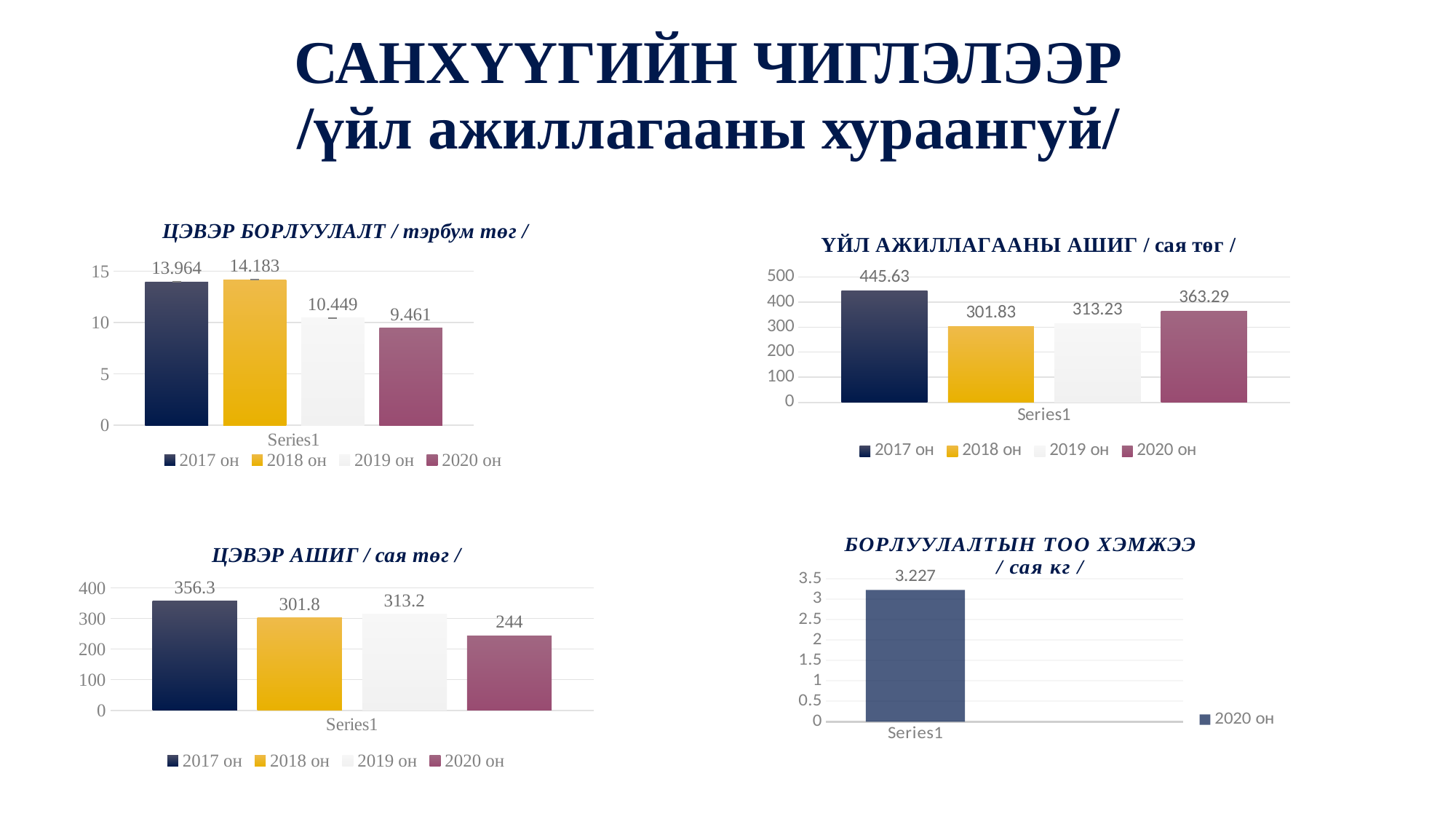
In the ЦЭВЭР АШИГ chart (bottom left), what is the value for 2020 он? 244 In the ЦЭВЭР АШИГ chart (bottom left), which is larger, the value for 2019 он or 2018 он? 2019 он In the ҮЙЛ АЖИЛЛАГААНЫ АШИГ chart (top right), what is the value for 2017 он? 445.63 In the ҮЙЛ АЖИЛЛАГААНЫ АШИГ chart (top right), which year has the highest value? 2017 он In the ЦЭВЭР БОРЛУУЛАЛТ chart (top left), which year has the lowest value? 2020 он In the ЦЭВЭР БОРЛУУЛАЛТ chart (top left), what is the value for 2018 он? 14.183 In the ЦЭВЭР АШИГ chart (bottom left), what is the difference between the 2017 он and 2020 он values? 112.3 In the ҮЙЛ АЖИЛЛАГААНЫ АШИГ chart (top right), how much larger is the 2017 он value than the 2018 он value? 143.8 In the ЦЭВЭР БОРЛУУЛАЛТ chart (top left), what is the difference between the 2018 он and 2017 он values? 0.219 What type of chart is the ҮЙЛ АЖИЛЛАГААНЫ АШИГ chart (top right)? Bar chart How many series does the legend of the ЦЭВЭР АШИГ chart (bottom left) list? 4 In the БОРЛУУЛАЛТЫН ТОО ХЭМЖЭЭ chart (bottom right), what is the value for 2020 он? 3.227